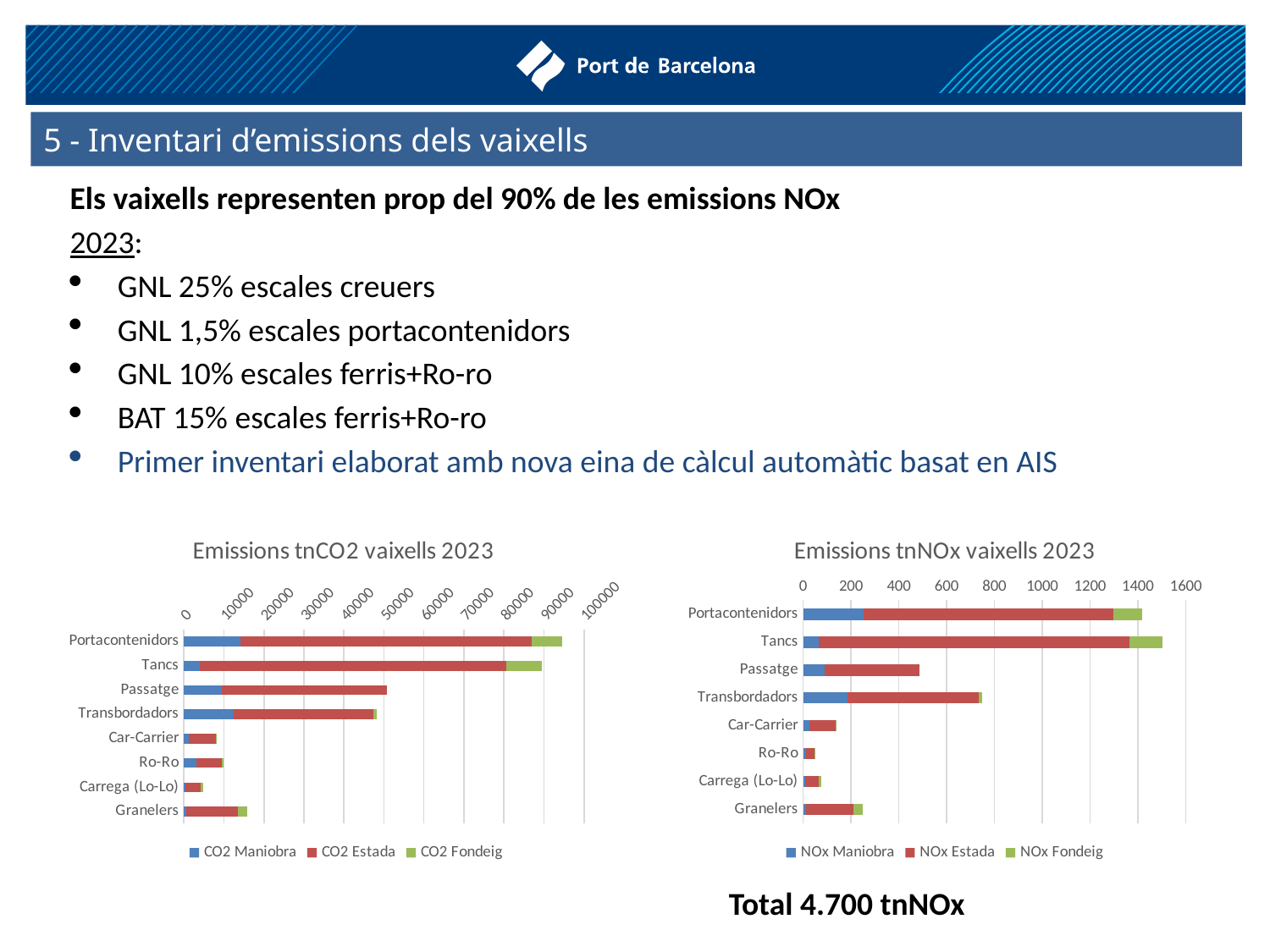
In the 'Emissions tnCO2 vaixells 2023' chart, is the total value for Passatge greater or less than 40000? greater What are the three legend entries of the 'Emissions tnNOx vaixells 2023' chart? NOx Maniobra, NOx Estada, NOx Fondeig In the 'Emissions tnCO2 vaixells 2023' chart, which category has the longest total bar? Portacontenidors How many ship categories are shown in the 'Emissions tnNOx vaixells 2023' chart? 8 In the 'Emissions tnCO2 vaixells 2023' chart, which has the larger total bar, Tancs or Passatge? Tancs What kind of chart is 'Emissions tnCO2 vaixells 2023'? bar chart How many series does the legend of the 'Emissions tnCO2 vaixells 2023' chart list? 3 In the 'Emissions tnNOx vaixells 2023' chart, is the total value for Transbordadors greater or less than 600? greater In the 'Emissions tnNOx vaixells 2023' chart, is the total value for Passatge greater or less than 600? less In the 'Emissions tnNOx vaixells 2023' chart, which has the larger total bar, Car-Carrier or Granelers? Granelers In the 'Emissions tnCO2 vaixells 2023' chart, which category has the shortest total bar? Carrega (Lo-Lo) In the 'Emissions tnNOx vaixells 2023' chart, which category has the longest total bar? Tancs